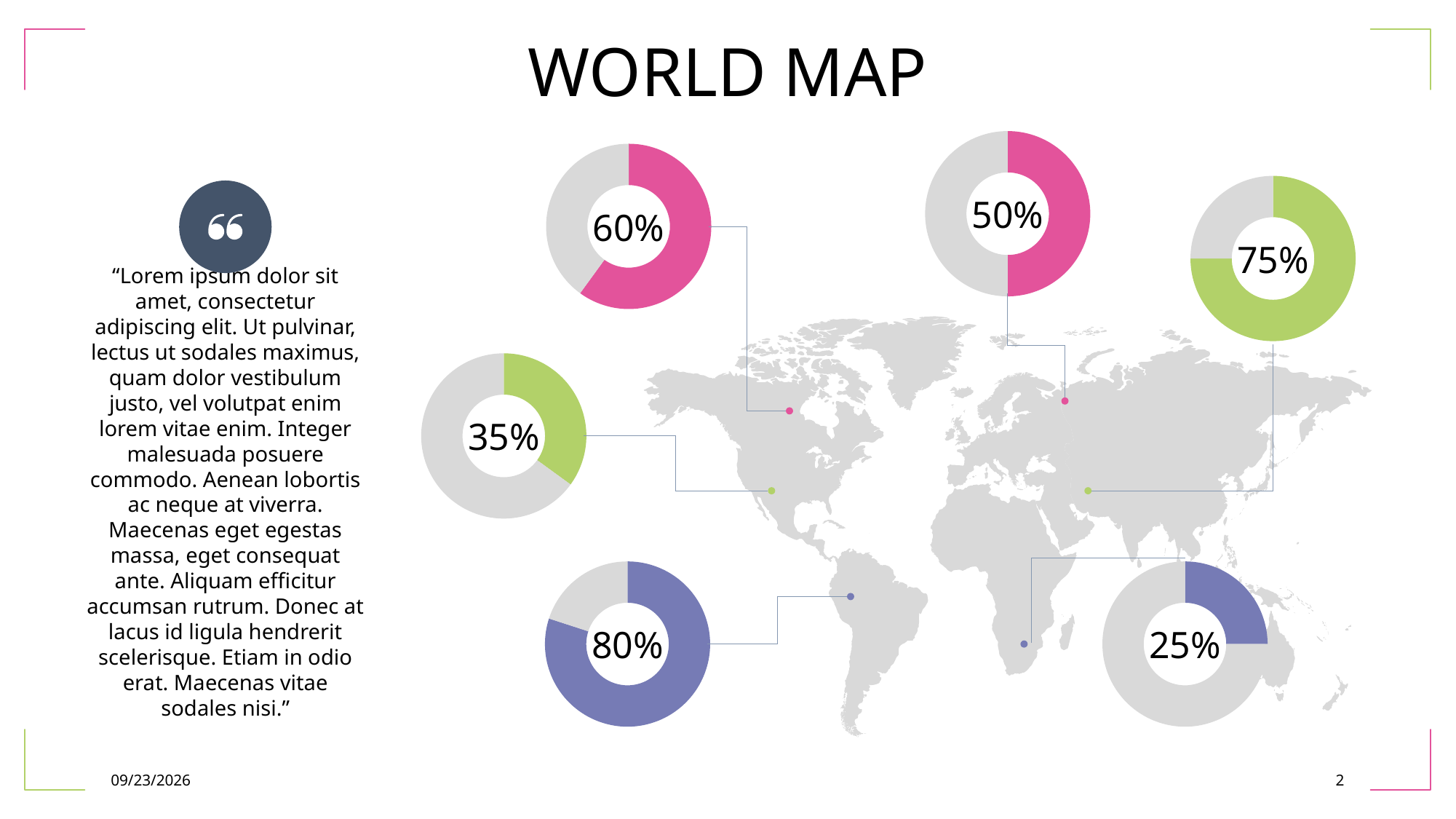
Which is larger, the value in the top-left donut chart or the value in the top-right donut chart? The top-right chart (75%) What colour is the filled portion of the bottom-left donut chart showing 80%? Purple What value is shown in the top-right donut chart on the slide? 75% Which donut chart on the slide shows the highest percentage? The bottom-left chart (80%) What value is shown in the donut chart at the top centre of the slide? 50% What value is shown in the donut chart on the middle left of the slide? 35% What is the difference between the value in the bottom-left donut chart and the value in the bottom-right donut chart? 55% What value is shown in the bottom-left donut chart on the slide? 80% How many donut charts are shown on the slide? 6 Which donut chart on the slide shows the lowest percentage? The bottom-right chart (25%) What value is shown in the top-left donut chart on the slide? 60% What value is shown in the bottom-right donut chart on the slide? 25%